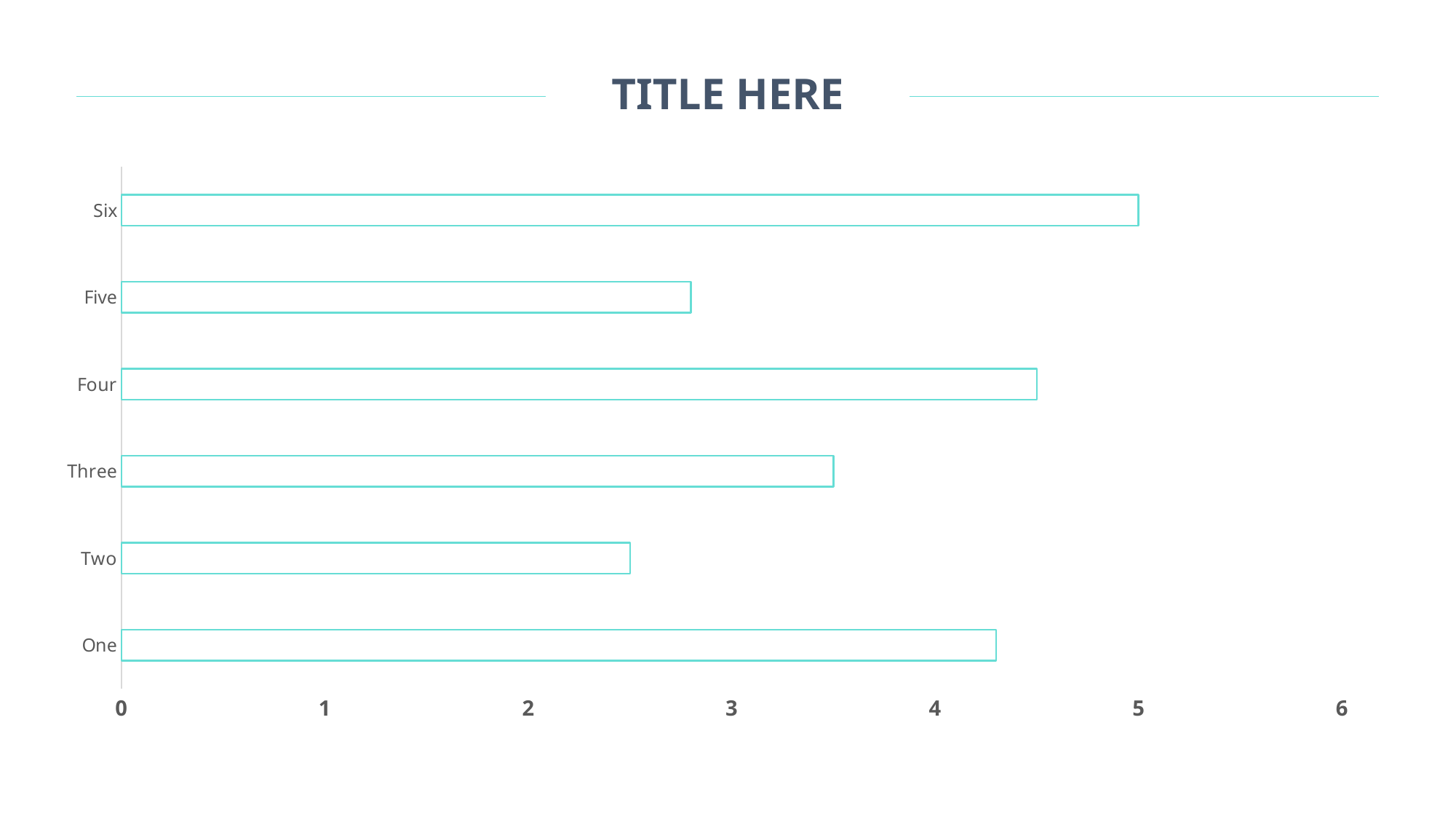
What is the title of the slide? TITLE HERE Is the value for Four greater or less than 4? greater Is the value for Five greater or less than 3? less Which category has the highest value? Six Is the value for One greater or less than 4? greater What is the value for Six? 5 Which has the larger value, Five or Two? Five How many categories are plotted in the chart? 6 Which category has the lowest value? Two Which has the larger value, Four or Three? Four What kind of chart is shown on the slide? bar chart